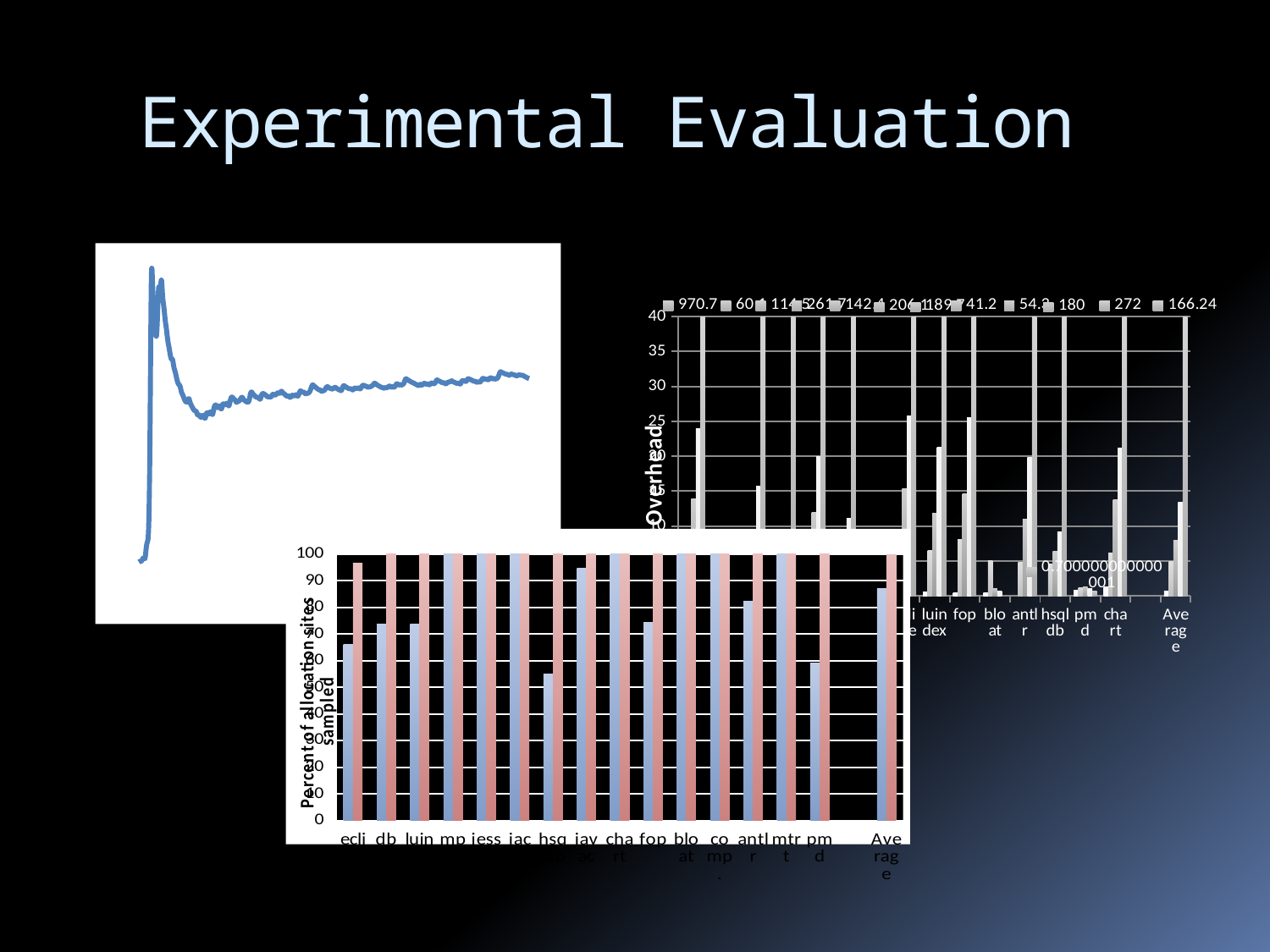
What is the y-axis label of the bottom chart? Percent of allocation sites sampled What is the y-axis label of the top-right chart? Overhead In the bottom chart, is the blue bar for Average greater or less than 80? greater In the bottom chart, is the blue bar for hsq greater or less than 50? greater What kind of chart is the top-right chart with the y-axis labelled Overhead? bar chart How many categories are shown on the x axis of the bottom chart? 16 In the bottom chart, which has the taller blue bar, db or hsq? db In the bottom chart, which is taller for hsq, the blue bar or the red bar? the red bar In the bottom chart, is the blue bar for ecli greater or less than 50? greater How many data series are plotted in the bottom chart? 2 What kind of chart is the top-left chart on the slide? line chart What kind of chart is the bottom chart on the slide? bar chart